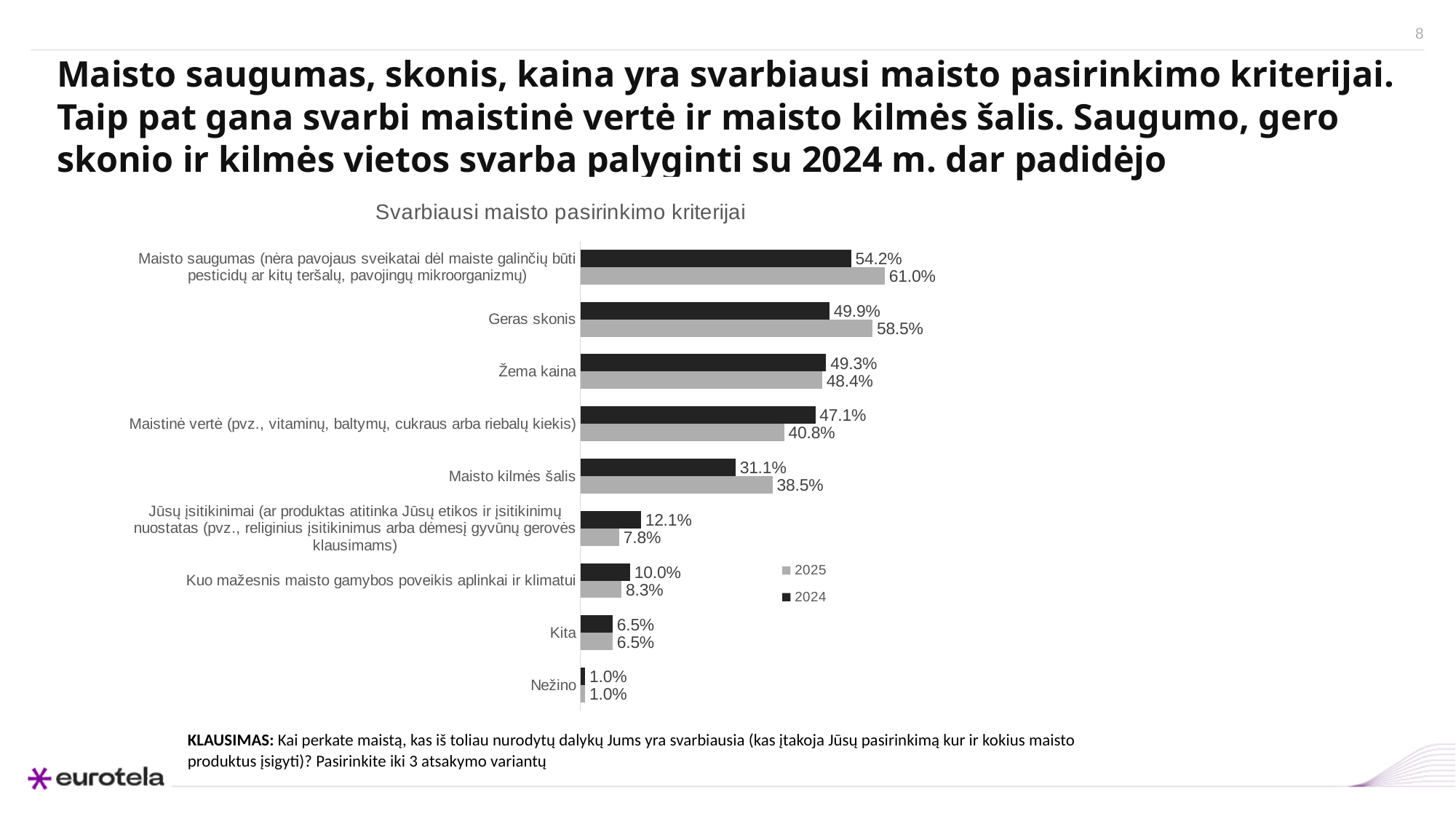
Which category has the highest 2025 value? Maisto saugumas (nėra pavojaus sveikatai dėl maiste galinčių būti pesticidų ar kitų teršalų, pavojingų mikroorganizmų) What is the 2025 value for Geras skonis? 58.5% For Maistinė vertė (pvz., vitaminų, baltymų, cukraus arba riebalų kiekis), which year has the larger value, 2024 or 2025? 2024 For Žema kaina, which year has the larger value, 2024 or 2025? 2024 What type of chart is shown on the slide? Bar chart How many series does the legend list? 2 How many categories are shown in the chart? 9 What is the difference between the 2025 and 2024 values for Geras skonis? 8.6% Which category has the lowest 2024 value? Nežino What is the 2024 value for Maisto kilmės šalis? 31.1% What is the difference between the 2025 and 2024 values for Maisto kilmės šalis? 7.4% What is the 2025 value for Žema kaina? 48.4%